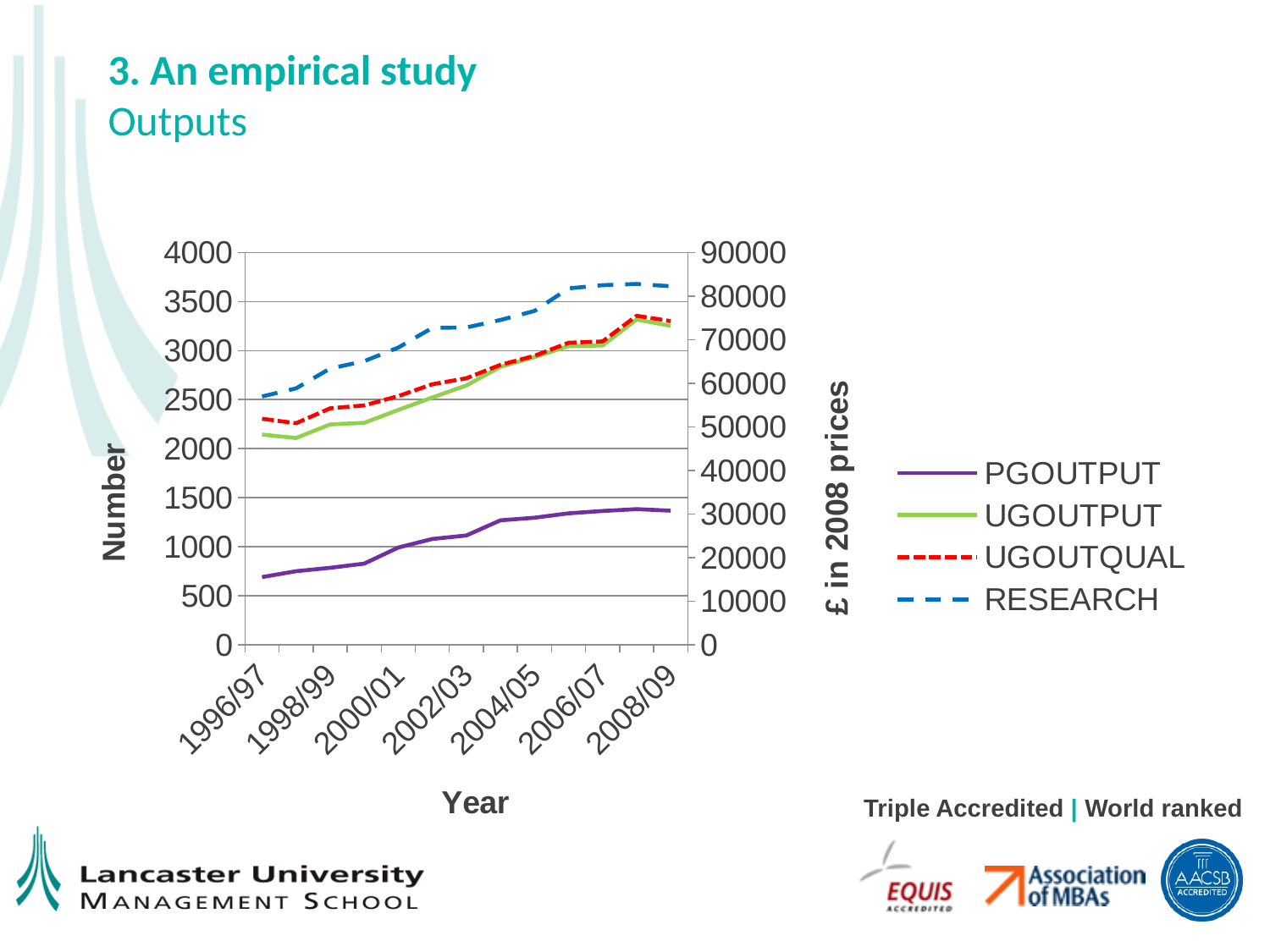
What kind of chart is shown on the slide? Line chart Which series are listed in the chart's legend? PGOUTPUT, UGOUTPUT, UGOUTQUAL, RESEARCH Does the PGOUTPUT line rise or fall overall from 1996/97 to 2008/09? Rise What is the title of the left vertical axis of the chart? Number Is the UGOUTPUT value for 2008/09, read on the left axis, greater or less than 3000? greater Which series is plotted as the lowest line on the chart across all years? PGOUTPUT How many year labels are shown along the x axis of the chart? 7 Is the UGOUTPUT value for 1996/97, read on the left axis, greater or less than 2000? greater How many series does the chart's legend list? 4 Is the PGOUTPUT value for 1996/97, read on the left axis, greater or less than 1000? less Does the RESEARCH line rise or fall overall from 1996/97 to 2008/09? Rise